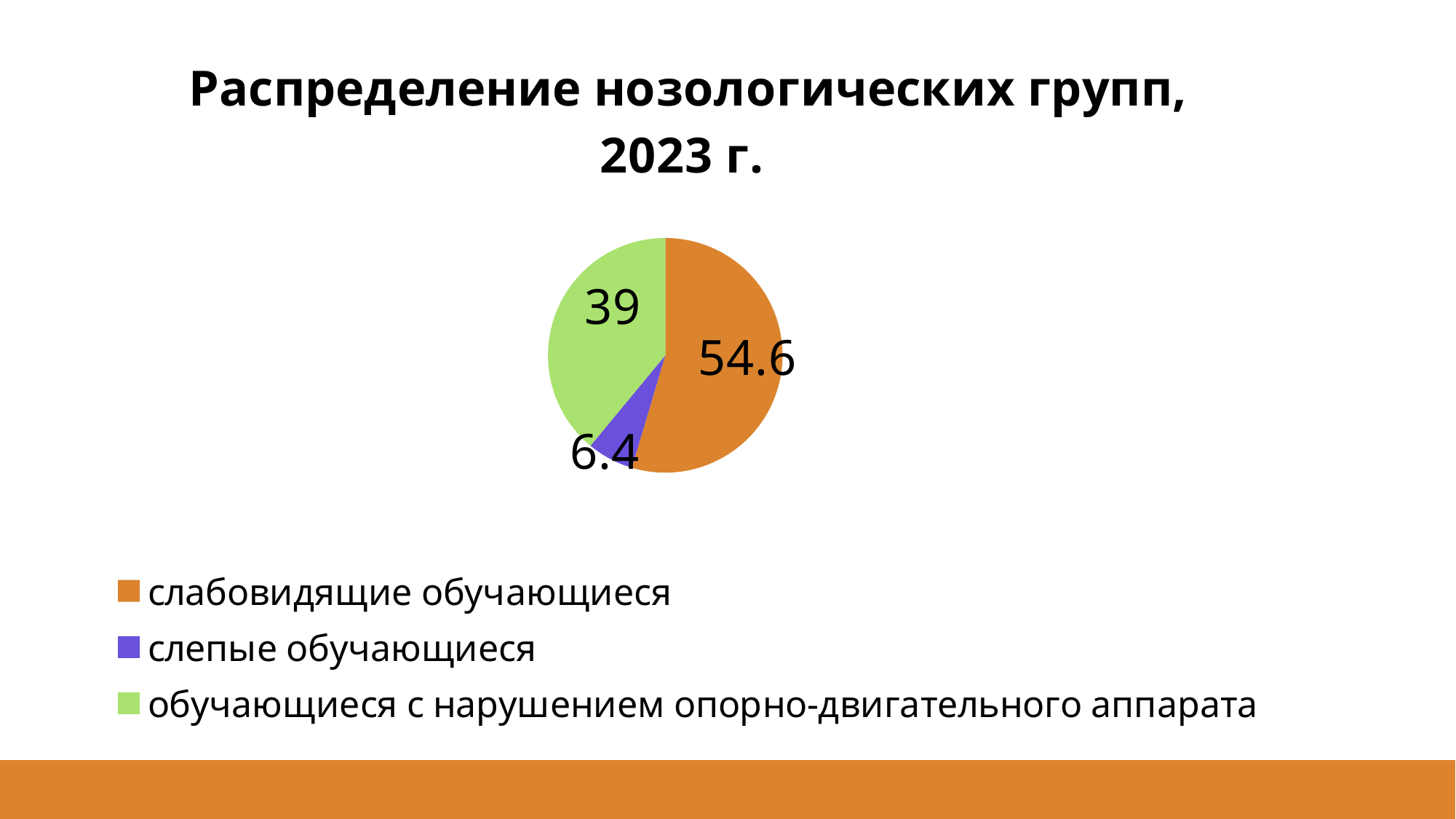
What is the difference between the values for слабовидящие обучающиеся and обучающиеся с нарушением опорно-двигательного аппарата? 15.6 How many slices does the pie chart have? 3 Which colour represents слепые обучающиеся in the chart? purple Which is larger: the value for слепые обучающиеся or the value for обучающиеся с нарушением опорно-двигательного аппарата? обучающиеся с нарушением опорно-двигательного аппарата What is the value for слепые обучающиеся? 6.4 What is the title of the chart? Распределение нозологических групп, 2023 г. What is the difference between the values for обучающиеся с нарушением опорно-двигательного аппарата and слепые обучающиеся? 32.6 Which category has the largest slice? слабовидящие обучающиеся What is the value for обучающиеся с нарушением опорно-двигательного аппарата? 39 Which category has the smallest slice? слепые обучающиеся What kind of chart is shown on the slide? pie chart What is the value for слабовидящие обучающиеся? 54.6